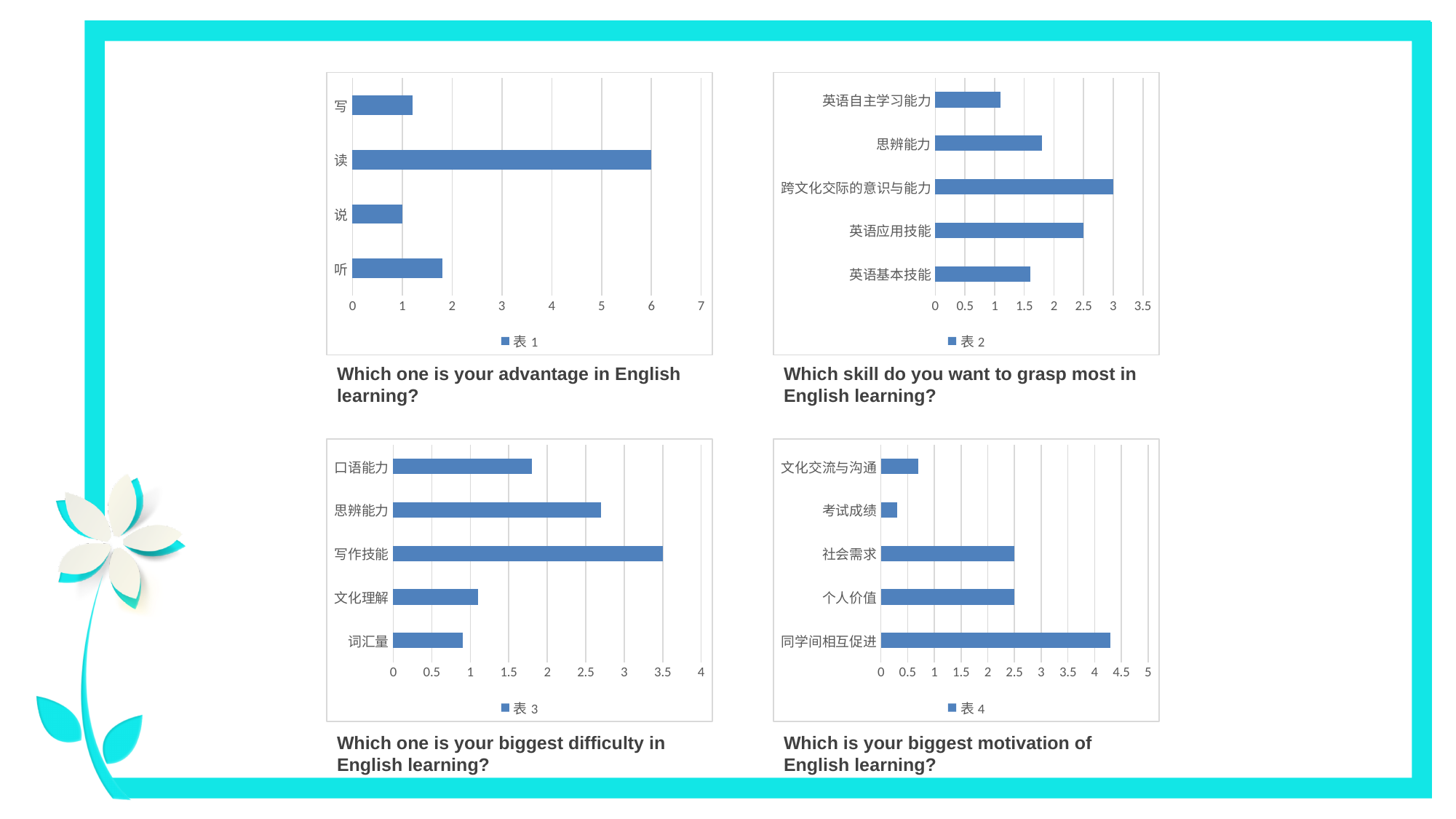
In the chart captioned "Which skill do you want to grasp most in English learning?", which category has the highest value? 跨文化交际的意识与能力 In the chart captioned "Which skill do you want to grasp most in English learning?", what is the value for 英语应用技能? 2.5 In the chart captioned "Which one is your advantage in English learning?", which category has the lowest value? 说 In the chart captioned "Which is your biggest motivation of English learning?", is the value for 同学间相互促进 greater or less than 4? greater In the chart captioned "Which skill do you want to grasp most in English learning?", is the value for 英语自主学习能力 greater or less than 1.5? less In the chart captioned "Which one is your advantage in English learning?", how many categories are shown? 4 In the chart captioned "Which one is your advantage in English learning?", which category has the highest value? 读 In the chart captioned "Which is your biggest motivation of English learning?", which category has the lowest value? 考试成绩 In the chart captioned "Which one is your advantage in English learning?", what is the value for 读? 6 In the chart captioned "Which one is your biggest difficulty in English learning?", which is larger, 思辨能力 or 口语能力? 思辨能力 What type of chart is the one captioned "Which is your biggest motivation of English learning?"? bar chart In the chart captioned "Which one is your biggest difficulty in English learning?", what is the value for 写作技能? 3.5